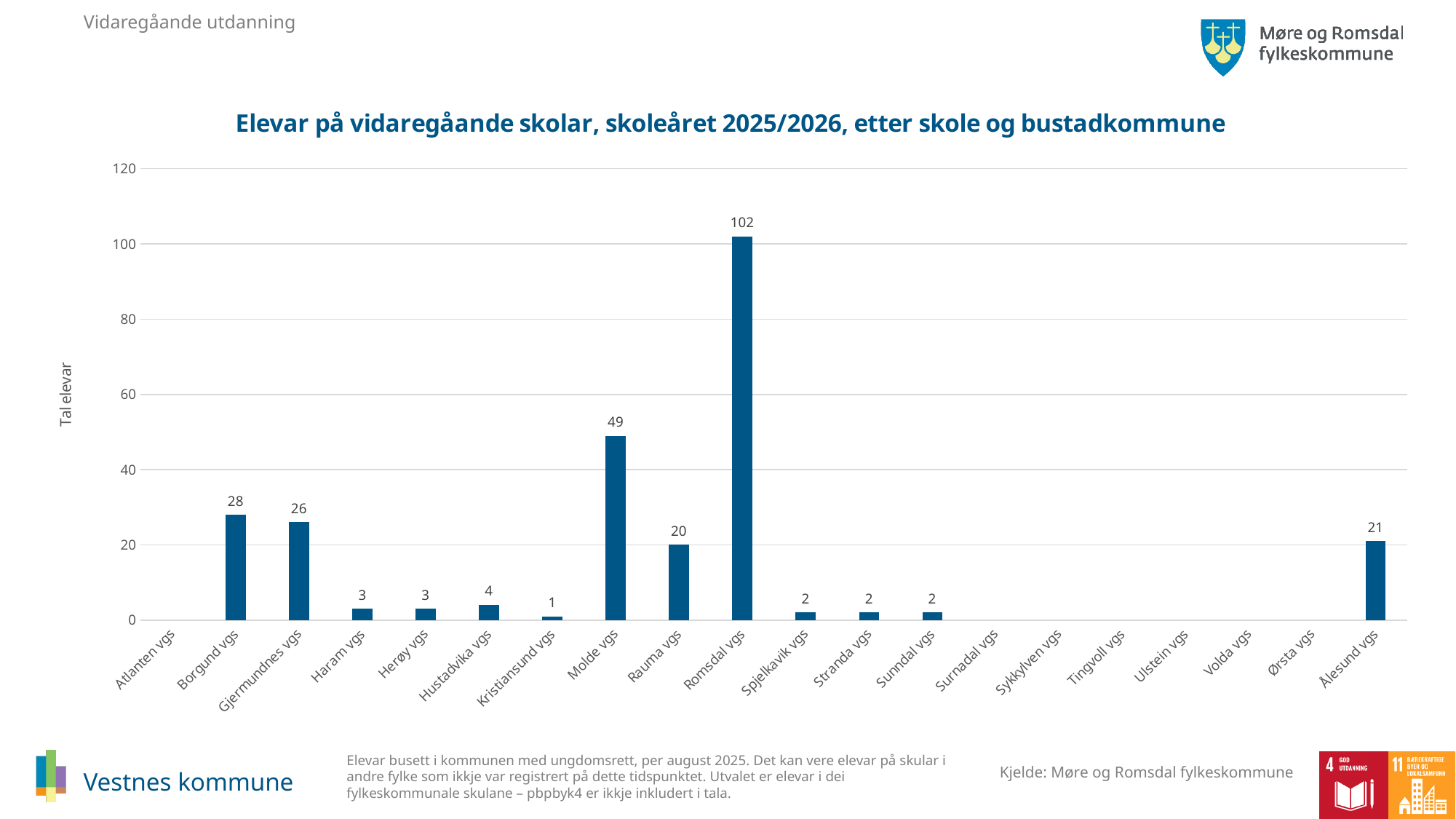
Which school has the highest number of pupils? Romsdal vgs What is the value for Ålesund vgs? 21 What is the value for Romsdal vgs? 102 Is the value for Romsdal vgs greater or less than 100? greater How many schools are listed on the x axis? 20 What is the difference between the values for Romsdal vgs and Molde vgs? 53 Which is larger, the value for Rauma vgs or the value for Ålesund vgs? Ålesund vgs What is the difference between the values for Borgund vgs and Gjermundnes vgs? 2 What is the value for Molde vgs? 49 What is the label of the y axis? Tal elevar What is the value for Kristiansund vgs? 1 What kind of chart is shown on the slide? bar chart